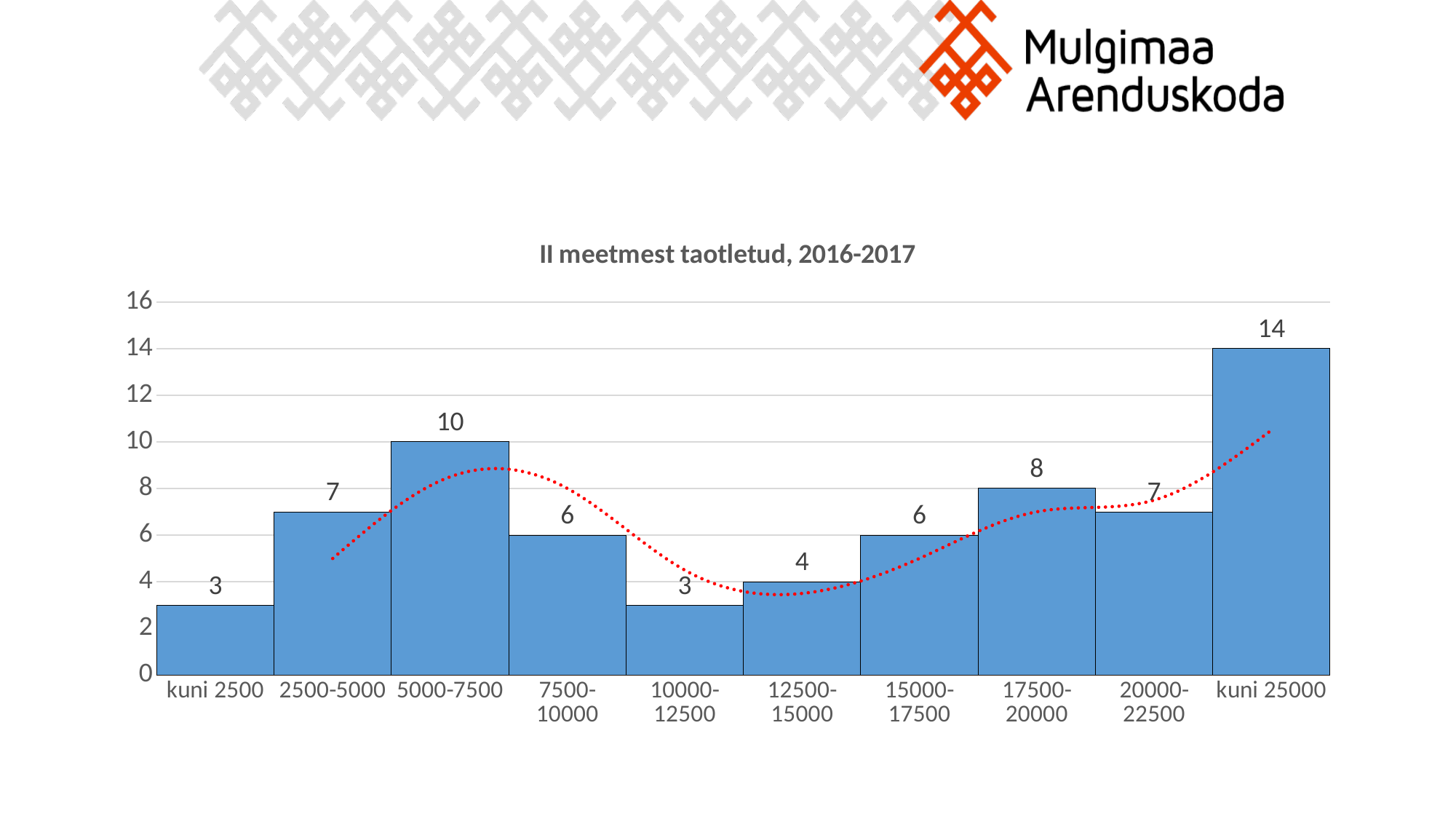
Which category has the highest value? kuni 25000 How many categories are shown on the x axis? 10 What is the difference between the values for kuni 25000 and 5000-7500? 4 What colour is the dotted trend line on the chart? red What is the value for the 5000-7500 category? 10 What is the value for the kuni 25000 category? 14 What is the value for the 12500-15000 category? 4 Which is larger, the value for 17500-20000 or the value for 20000-22500? 17500-20000 What is the difference between the values for 7500-10000 and 10000-12500? 3 What kind of chart is shown on the slide? bar chart Is the value for 2500-5000 greater or less than 6? greater What is the title of the chart? II meetmest taotletud, 2016-2017